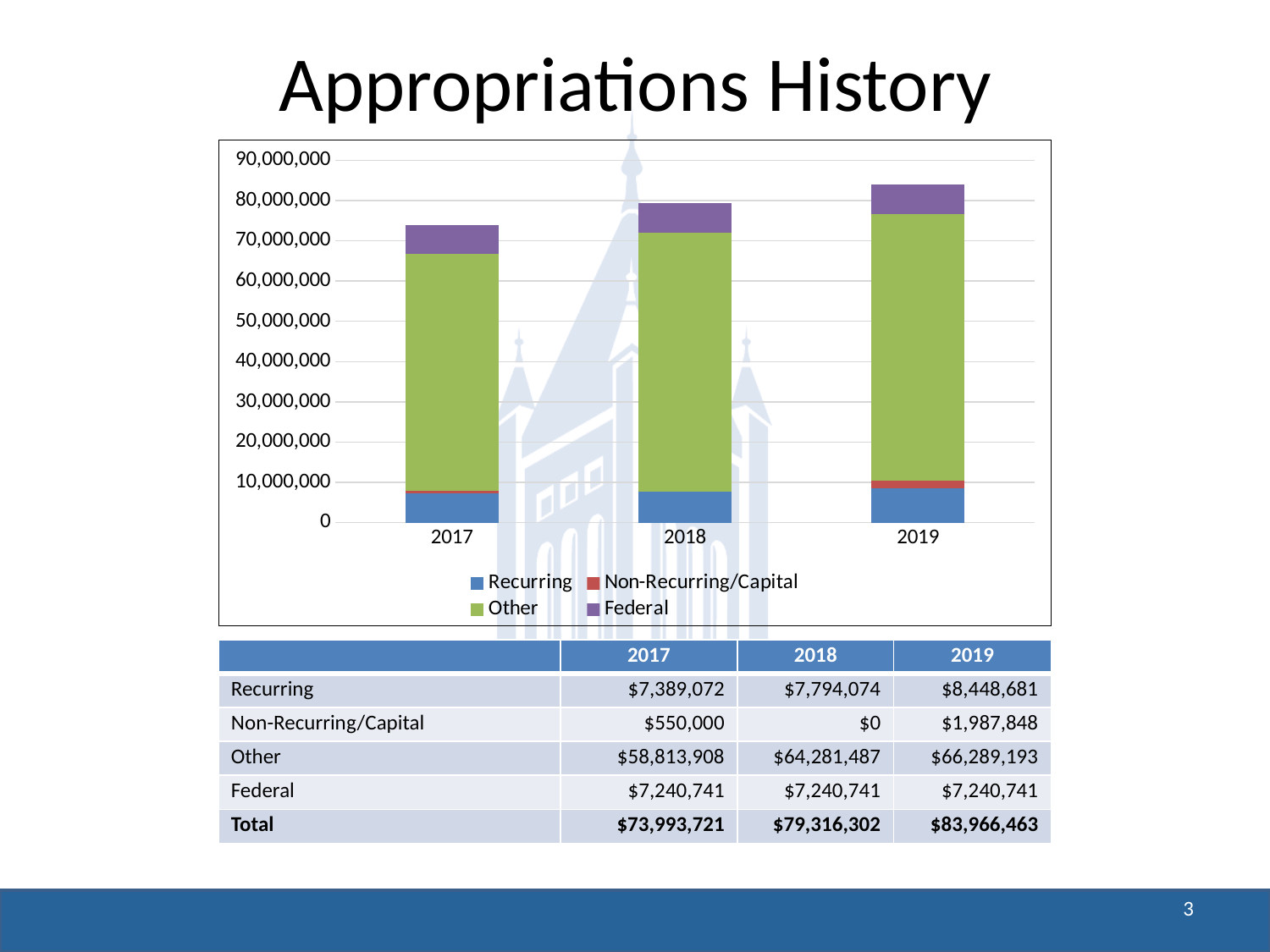
How many years are shown on the x axis of the chart? 3 What kind of chart is shown on the slide? stacked bar chart What is the value of Other in 2018? $64,281,487 Which year has the lowest total appropriation? 2017 Which year has the highest total appropriation? 2019 Which colour represents the Federal series in the chart? purple What is the difference between the total appropriations for 2019 and 2018? $4,650,161 How many series does the chart legend list? 4 Do total appropriations rise or fall from 2017 to 2019? rise What is the total appropriation for 2019? $83,966,463 What is the Recurring value for 2017? $7,389,072 Is the Recurring value larger in 2019 or in 2017? 2019